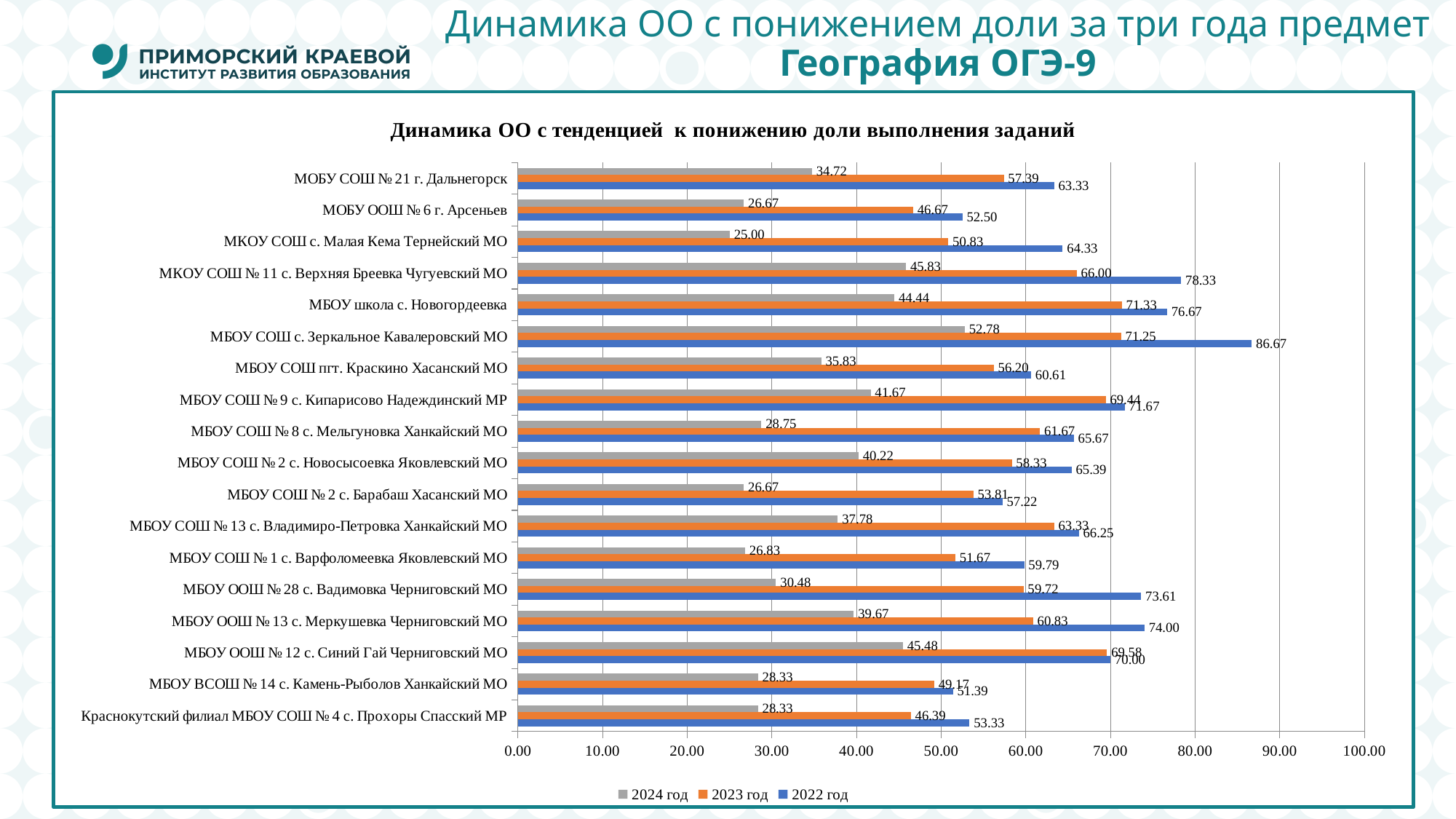
How many organisations are listed on the chart? 18 Which organisation has the lowest 2024 год value? МКОУ СОШ с. Малая Кема Тернейский МО What is the 2023 год value for МБОУ ООШ № 28 с. Вадимовка Черниговский МО? 59.72 What kind of chart is shown on the slide? bar chart What is the 2024 год value for МБОУ СОШ с. Зеркальное Кавалеровский МО? 52.78 Which organisation has the highest 2022 год value? МБОУ СОШ с. Зеркальное Кавалеровский МО What is the 2022 год value for МКОУ СОШ № 11 с. Верхняя Бреевка Чугуевский МО? 78.33 Which is larger: the 2023 год value for МБОУ школа с. Новогордеевка or the 2023 год value for МБОУ СОШ пгт. Краскино Хасанский МО? МБОУ школа с. Новогордеевка Is the 2022 год value for МБОУ ООШ № 13 с. Меркушевка Черниговский МО greater or less than 70.00? greater What is the difference between the 2022 год and 2024 год values for МОБУ СОШ № 21 г. Дальнегорск? 28.61 What is the title of the chart? Динамика ОО с тенденцией к понижению доли выполнения заданий How many series does the legend list? 3